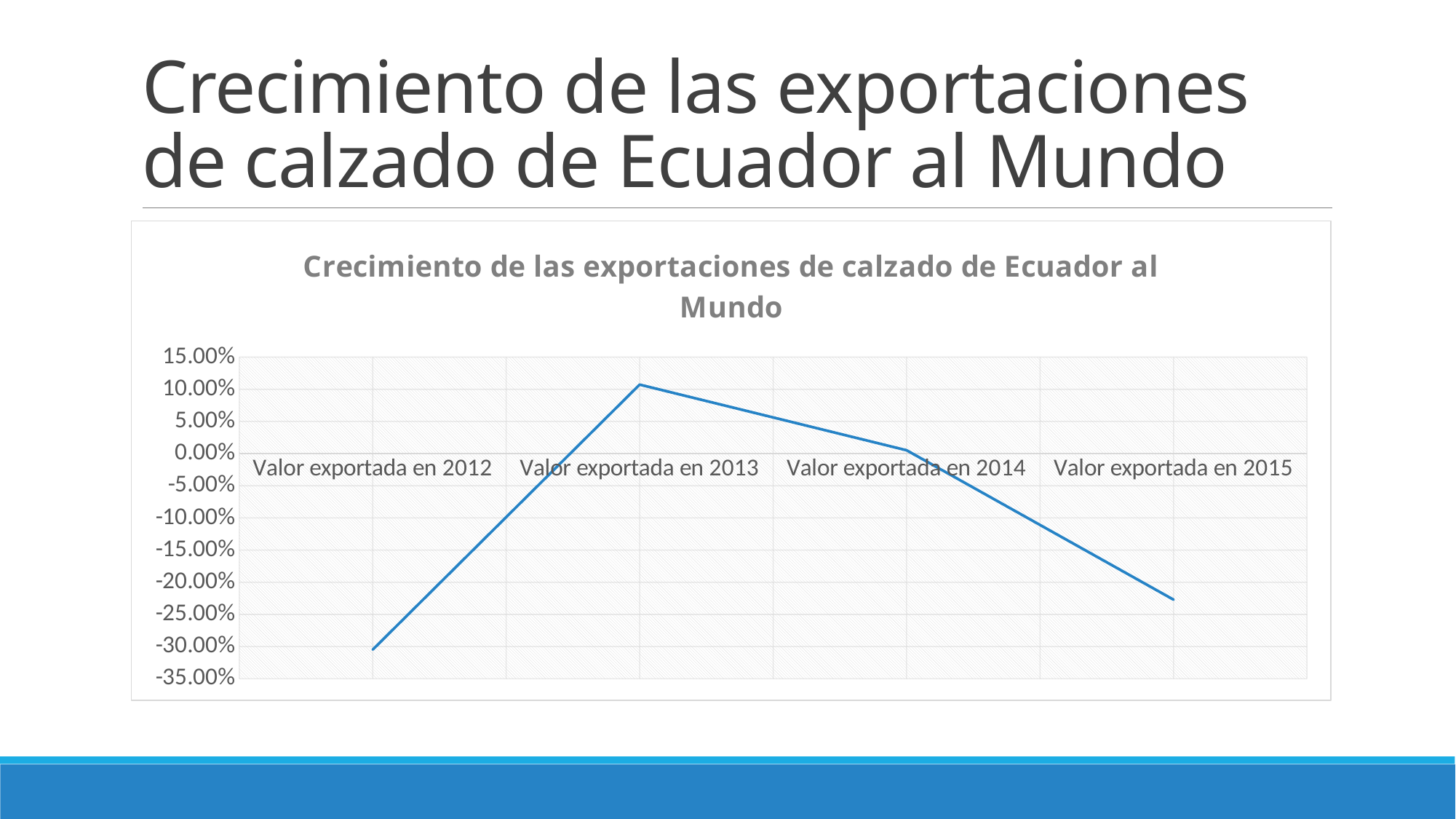
Which is larger, the value for Valor exportada en 2012 or Valor exportada en 2013? Valor exportada en 2013 Is the value for Valor exportada en 2013 greater or less than 5.00%? greater Does the line rise or fall from Valor exportada en 2013 to Valor exportada en 2015? fall What kind of chart is shown on the slide? line chart Is the value for Valor exportada en 2015 greater or less than -15.00%? less Is the value for Valor exportada en 2014 greater or less than 5.00%? less Which category has the highest value? Valor exportada en 2013 Which category has the lowest value? Valor exportada en 2012 Which is larger, the value for Valor exportada en 2014 or Valor exportada en 2015? Valor exportada en 2014 How many data points are plotted on the line? 4 What is the title of the chart? Crecimiento de las exportaciones de calzado de Ecuador al Mundo